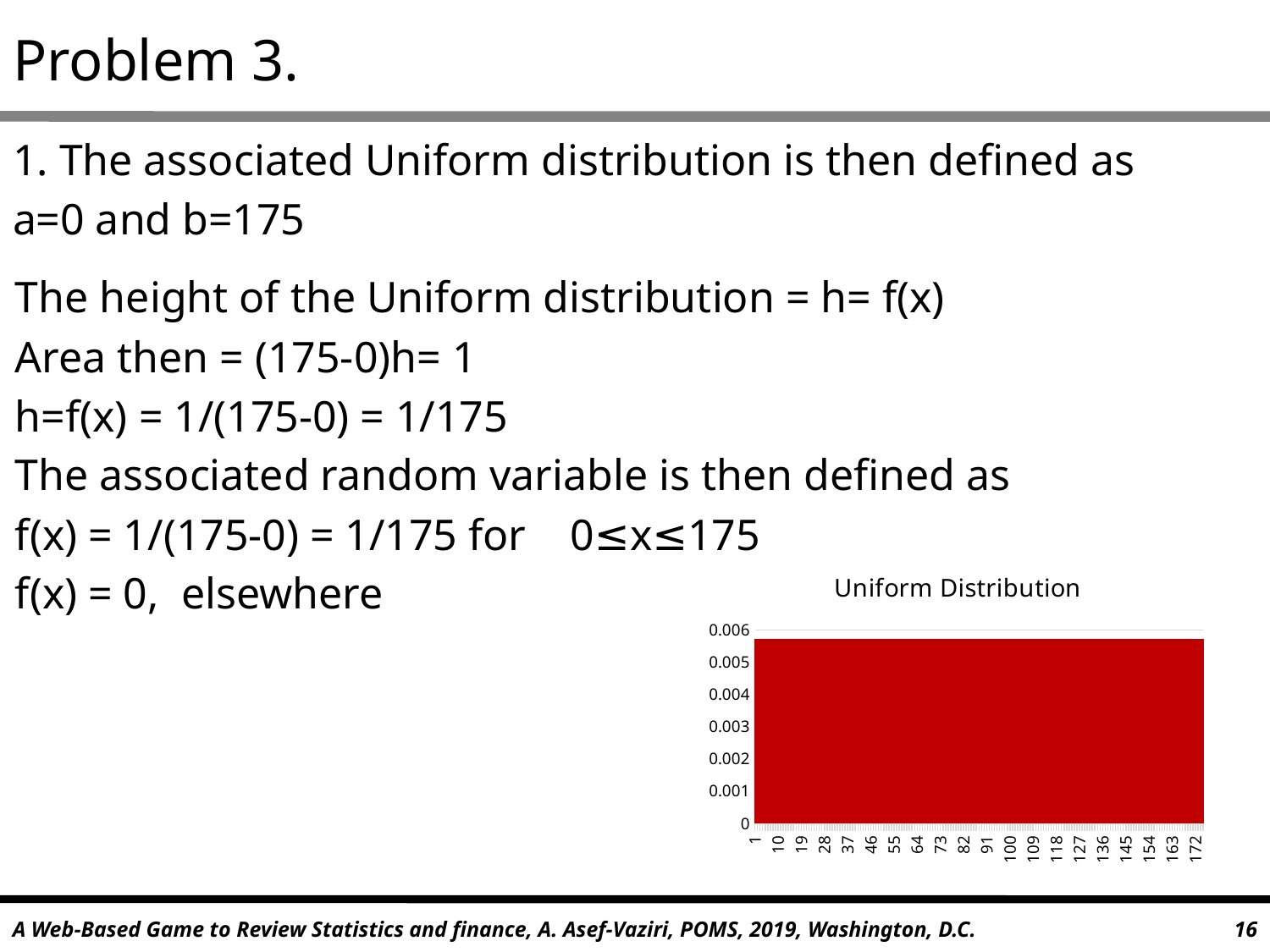
How many tick labels are printed along the horizontal axis of the chart? 20 Is the plotted value at x = 46 larger or smaller than the plotted value at x = 136, or are they the same? the same What is the title of the chart on the slide? Uniform Distribution Do the plotted values rise, fall, or stay constant as x increases from 1 to 172? stay constant Is the plotted value at x = 91 greater or less than 0.005? greater What is the highest value shown on the vertical axis of the chart? 0.006 What is the first label shown on the horizontal axis of the chart? 1 Is the plotted value at x = 172 greater or less than 0.003? greater What is the last label shown on the horizontal axis of the chart? 172